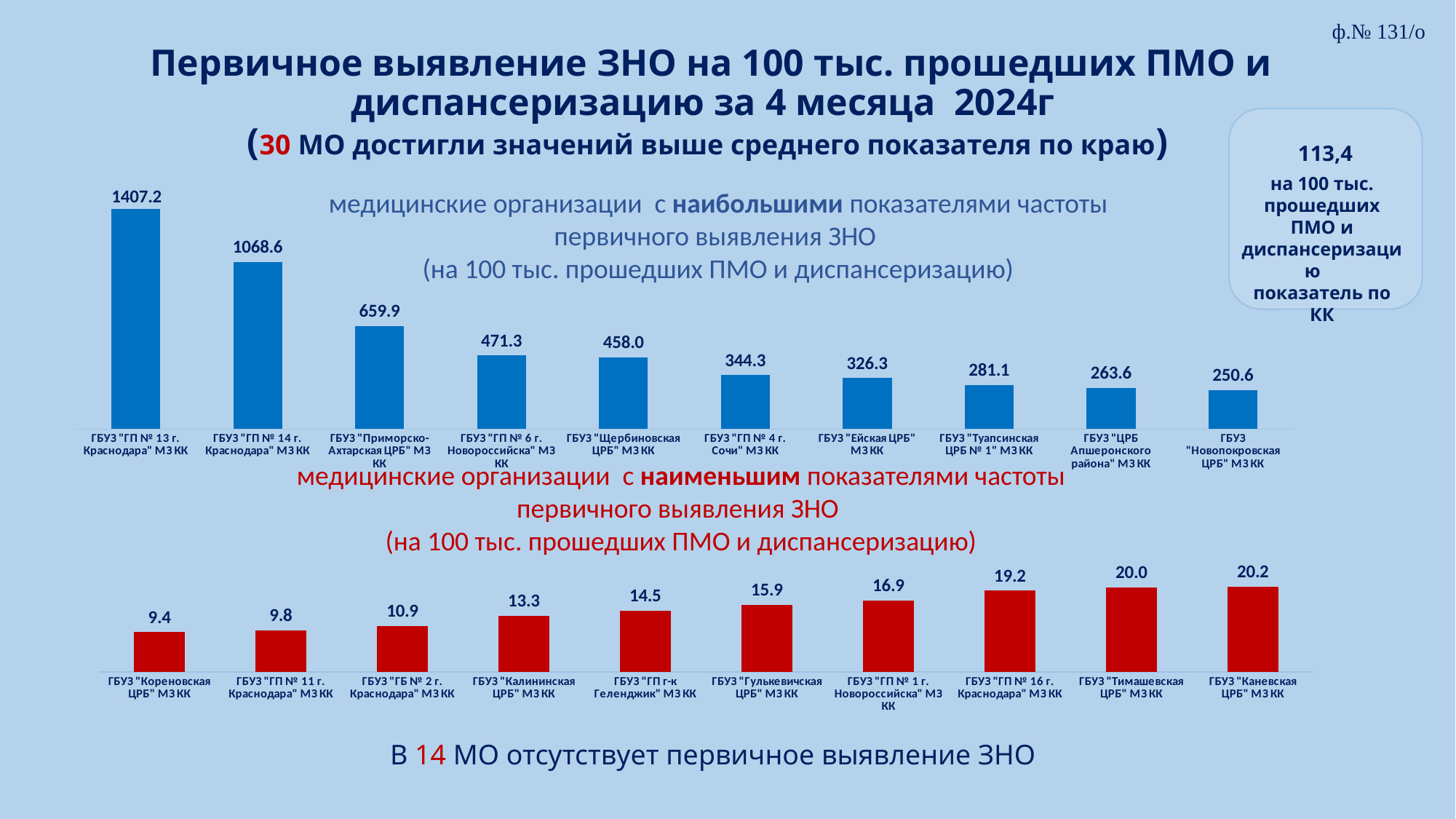
In the top chart (blue bars), what is the value for ГБУЗ "ГП № 13 г. Краснодара" МЗ КК? 1407.2 In the bottom chart (red bars), which is larger: the value for ГБУЗ "ГП г-к Геленджик" МЗ КК or ГБУЗ "Гулькевичская ЦРБ" МЗ КК? ГБУЗ "Гулькевичская ЦРБ" МЗ КК In the top chart (blue bars), which organization has the lowest value? ГБУЗ "Новопокровская ЦРБ" МЗ КК In the top chart (blue bars), what is the difference between the values for ГБУЗ "ГП № 13 г. Краснодара" МЗ КК and ГБУЗ "ГП № 14 г. Краснодара" МЗ КК? 338.6 In the bottom chart (red bars), which organization has the lowest value? ГБУЗ "Кореновская ЦРБ" МЗ КК In the bottom chart (red bars), what is the difference between the values for ГБУЗ "Тимашевская ЦРБ" МЗ КК and ГБУЗ "Кореновская ЦРБ" МЗ КК? 10.6 In the bottom chart (red bars), which organization has the highest value? ГБУЗ "Каневская ЦРБ" МЗ КК What type of chart is used on this slide? bar chart In the top chart (blue bars), how many organizations are shown? 10 In the top chart (blue bars), what is the value for ГБУЗ "Ейская ЦРБ" МЗ КК? 326.3 In the bottom chart (red bars), what is the value for ГБУЗ "Калининская ЦРБ" МЗ КК? 13.3 In the top chart (blue bars), do the values rise or fall from left to right? fall